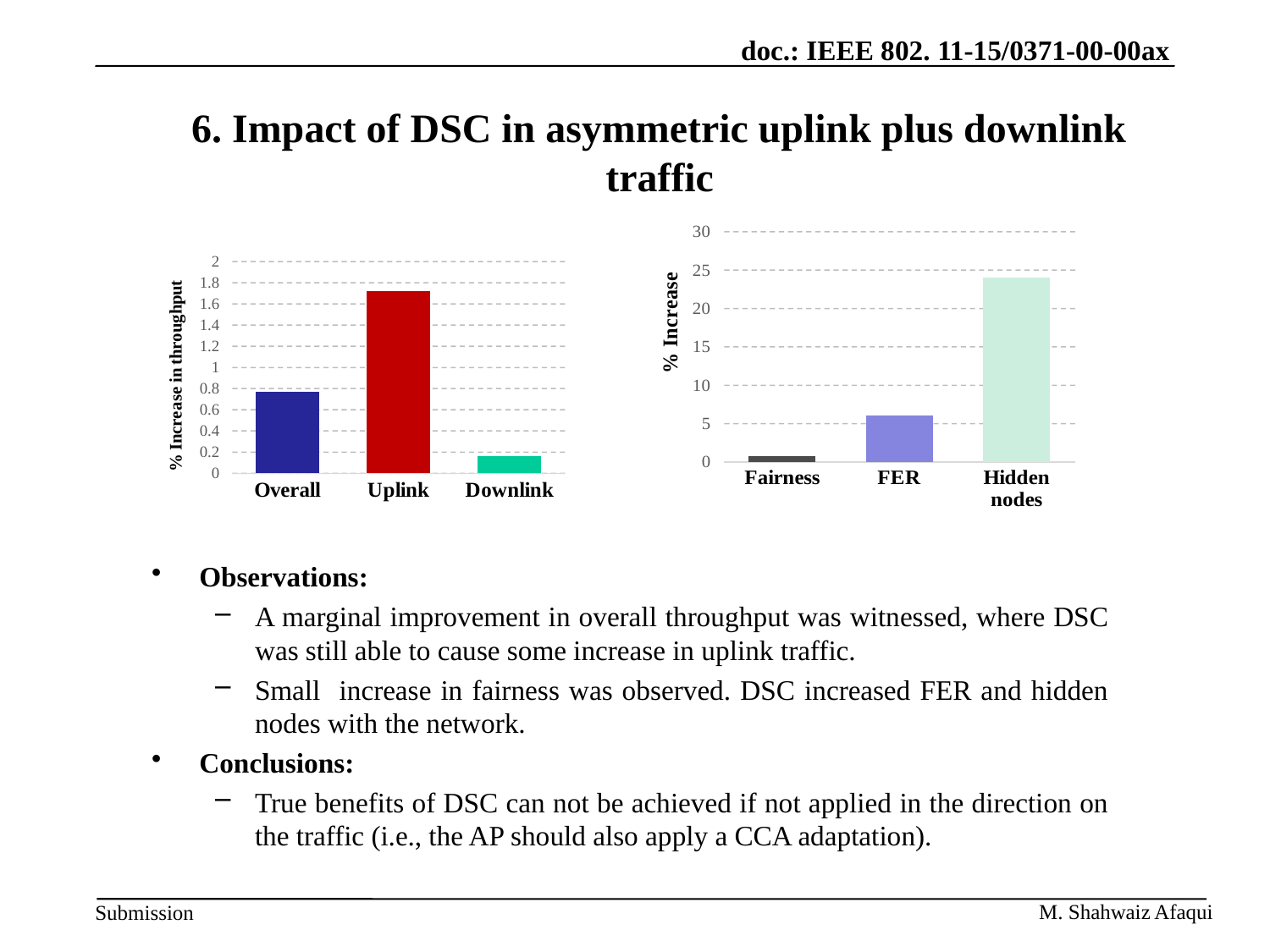
What type of chart is the left chart (% Increase in throughput)? Bar chart In the right chart (% Increase), which category has the lowest value? Fairness In the left chart (% Increase in throughput), how many categories are shown on the x axis? 3 In the left chart (% Increase in throughput), is the value for Downlink greater or less than 0.4? less In the right chart (% Increase), is the value for Hidden nodes greater or less than 20? greater In the left chart (% Increase in throughput), is the value for Overall greater or less than 1? less In the right chart (% Increase), which category has the highest value? Hidden nodes In the left chart (% Increase in throughput), which category has the lowest value? Downlink In the left chart (% Increase in throughput), which category has the highest value? Uplink In the right chart (% Increase), which is larger, the value for FER or the value for Fairness? FER